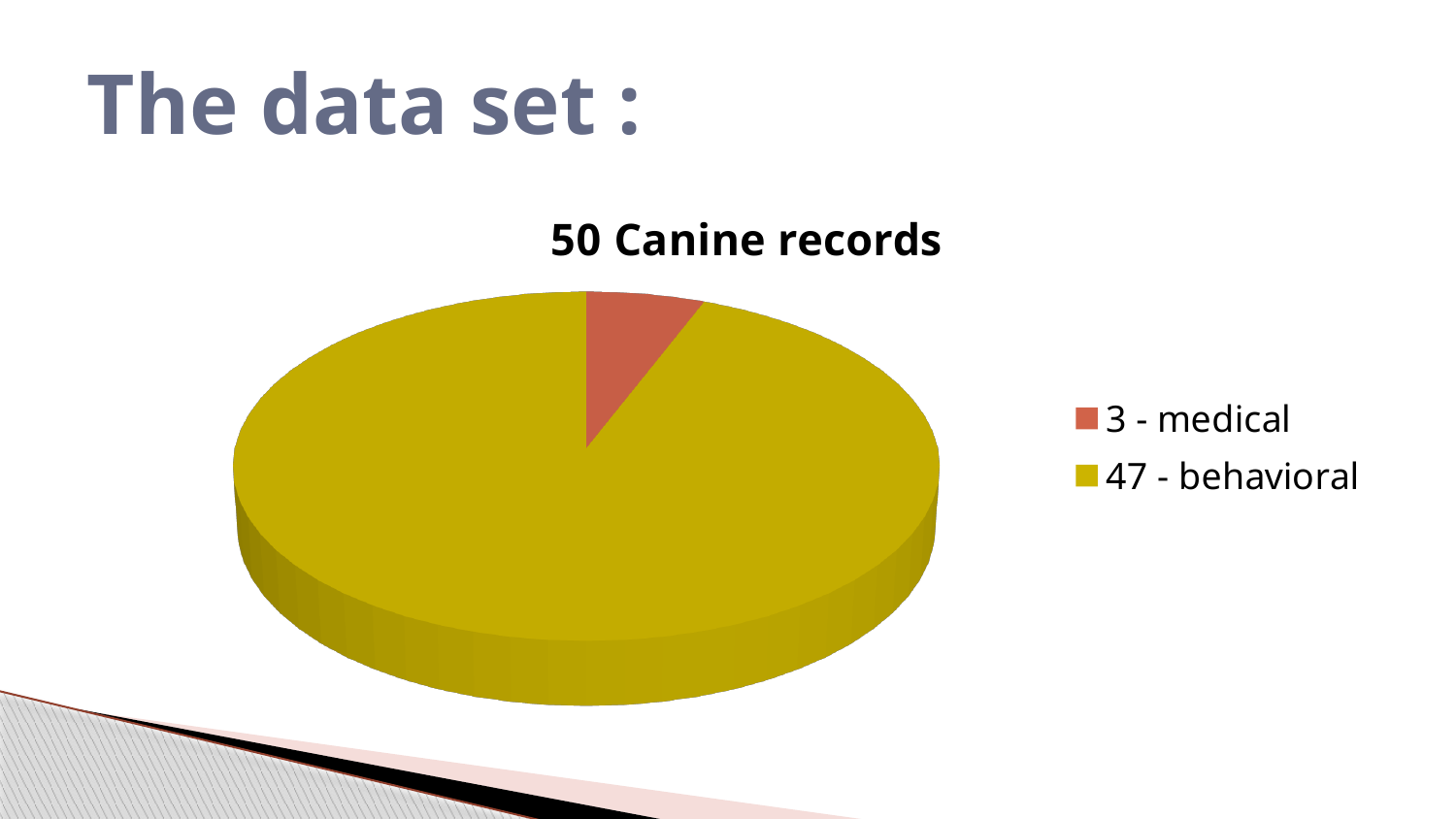
Which is larger, the number of medical records or the number of behavioral records? behavioral What share of the 50 canine records are medical? 6% How many slices does the pie chart have? 2 What kind of chart is shown on the slide? pie chart What colour is the behavioral slice of the pie? yellow How many records are medical according to the legend? 3 What is the difference between the number of behavioral records and the number of medical records? 44 Which category has the largest slice of the pie? behavioral Which category has the smallest slice of the pie? medical What is the title of the pie chart? 50 Canine records How many entries does the legend list? 2 How many records are behavioral according to the legend? 47